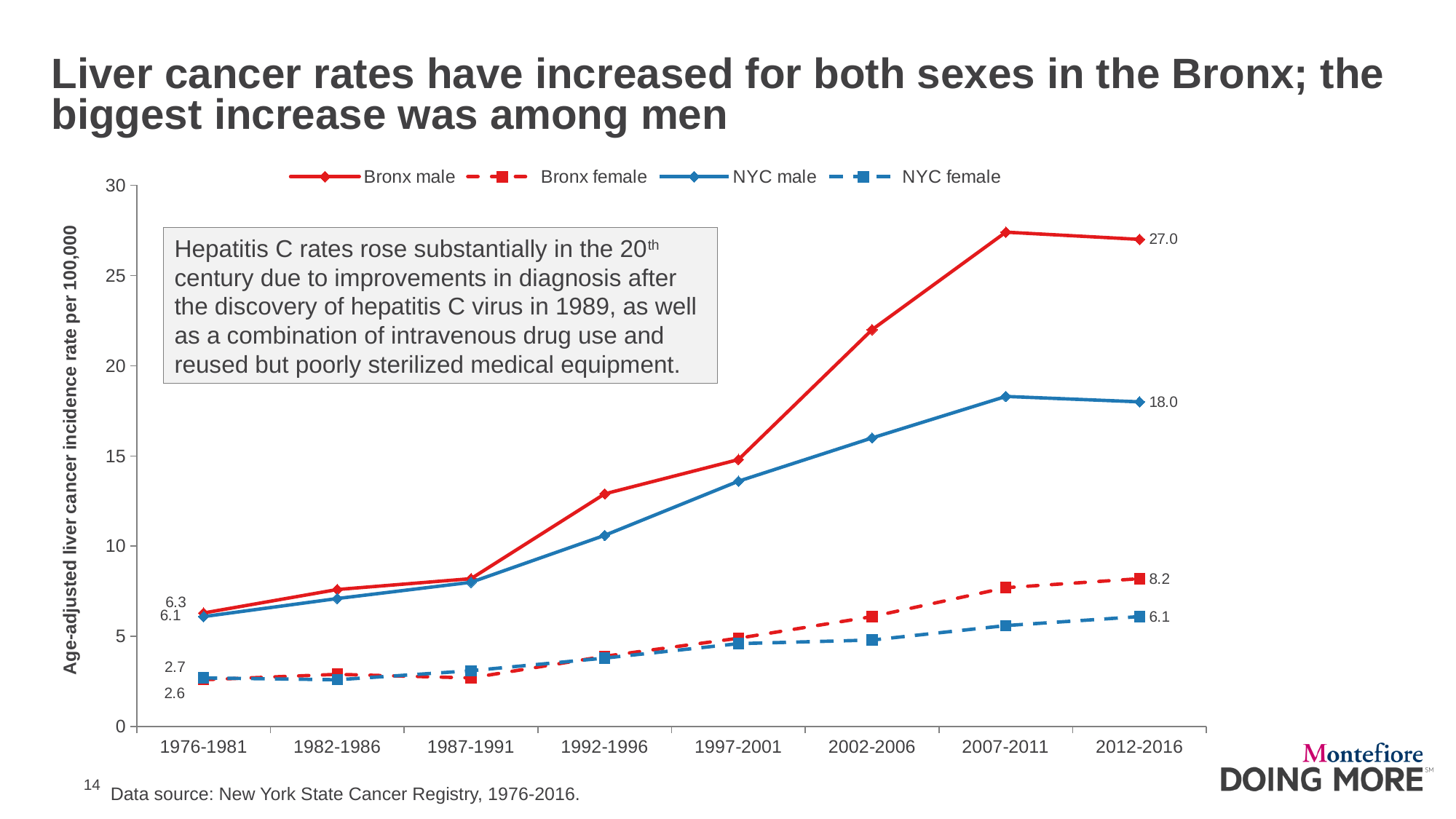
What kind of chart is shown on the slide? Line chart What is the Bronx male liver cancer incidence rate for 2012-2016? 27.0 Which series has the highest value in 2012-2016? Bronx male How many series does the legend list? 4 What is the NYC male liver cancer incidence rate for 2012-2016? 18.0 Is the Bronx male value for 2002-2006 greater or less than 20? greater What is the Bronx female liver cancer incidence rate for 2012-2016? 8.2 Which is larger in 2012-2016, the Bronx female rate or the NYC female rate? Bronx female What is the NYC female liver cancer incidence rate for 1976-1981? 2.7 How many time periods are shown on the x axis? 8 What is the difference between the Bronx male and NYC male rates in 2012-2016? 9.0 Which series has the lowest value in 2012-2016? NYC female